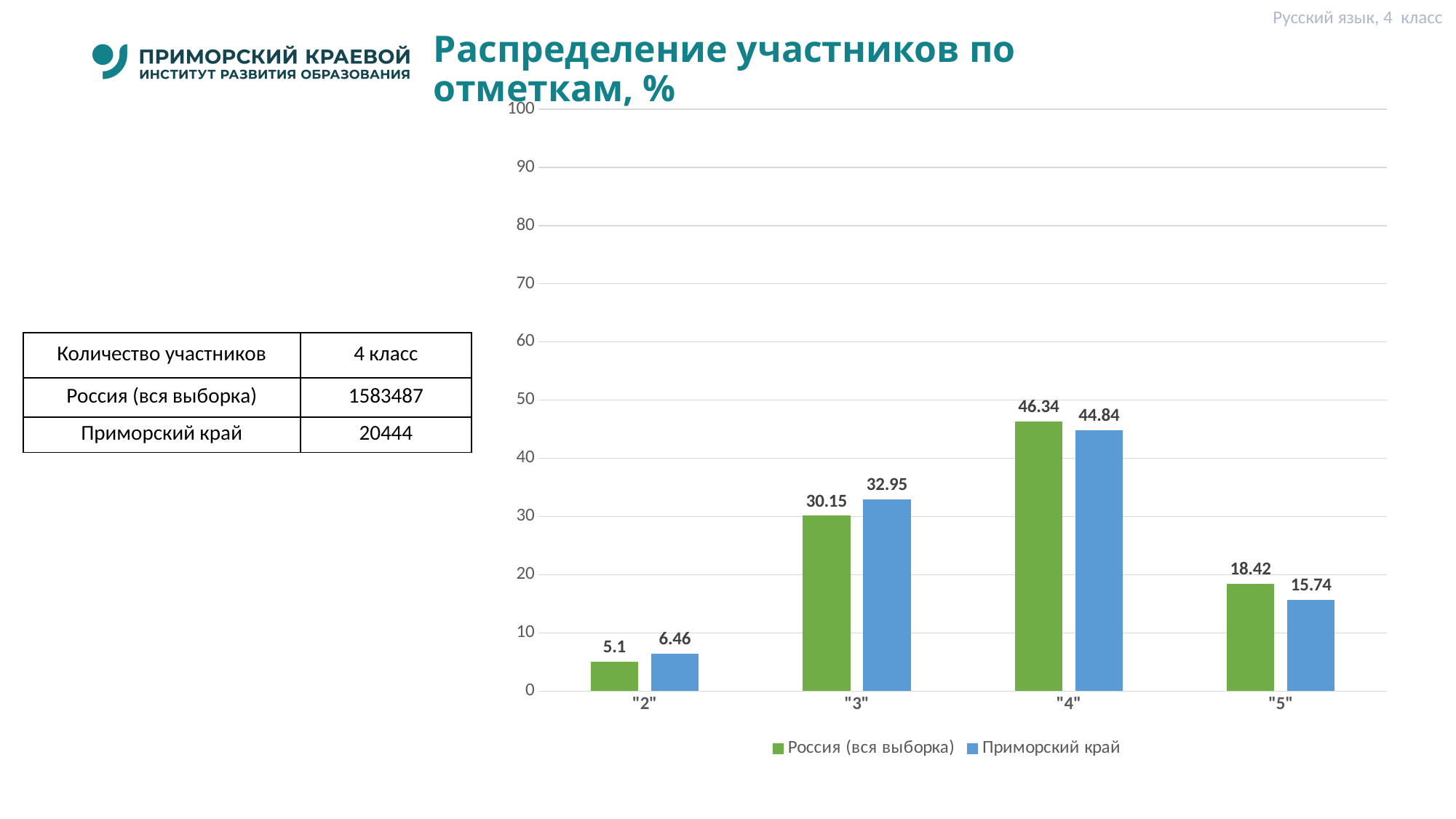
Which mark has the highest value for Приморский край? "4" How many series does the legend list? 2 What kind of chart is shown on the slide? Bar chart Which mark has the lowest value for Россия (вся выборка)? "2" What is the value for Приморский край for mark "3"? 32.95 What is the difference between Россия (вся выборка) and Приморский край for mark "5"? 2.68 What is the value for Россия (вся выборка) for mark "4"? 46.34 What is the value for Россия (вся выборка) for mark "5"? 18.42 How many mark categories are shown on the x axis? 4 What colour are the bars for Приморский край? Blue For mark "3", which series has the larger value: Россия (вся выборка) or Приморский край? Приморский край What is the value for Приморский край for mark "2"? 6.46